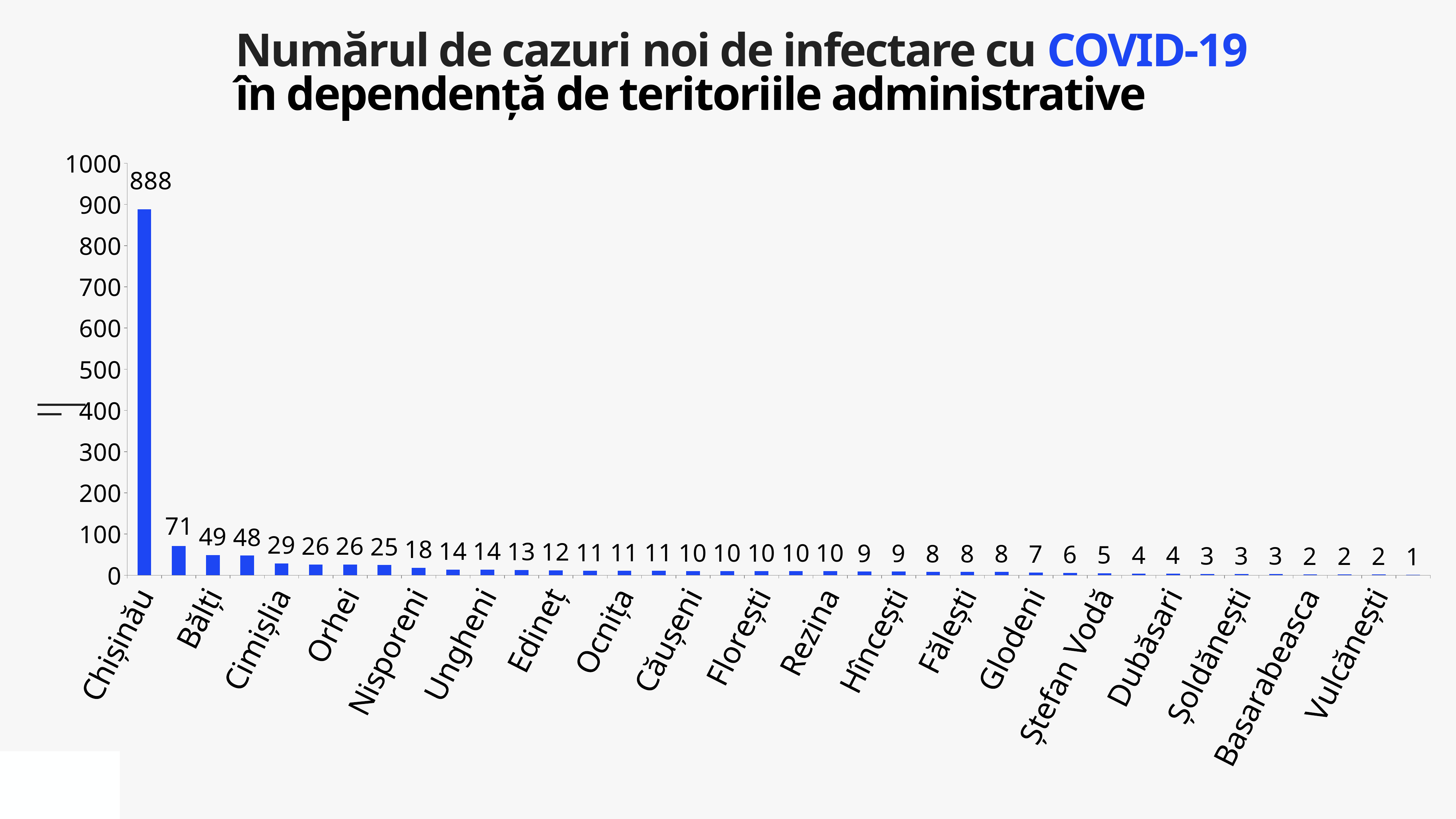
Which territory has the highest number of new cases? Chișinău What is the value for Vulcănești? 2 What kind of chart is shown on the slide? bar chart What is the highest value shown on the y axis? 1000 What is the title of the chart? Numărul de cazuri noi de infectare cu COVID-19 în dependență de teritoriile administrative Which is larger, the value for Chișinău or the value for Bălți? Chișinău What is the value for Chișinău? 888 What is the difference between the values for Chișinău and Vulcănești? 886 Is the value for Bălți greater or less than 100? less Is the value for Chișinău greater or less than 800? greater Do the values rise or fall from left to right along the x axis? fall